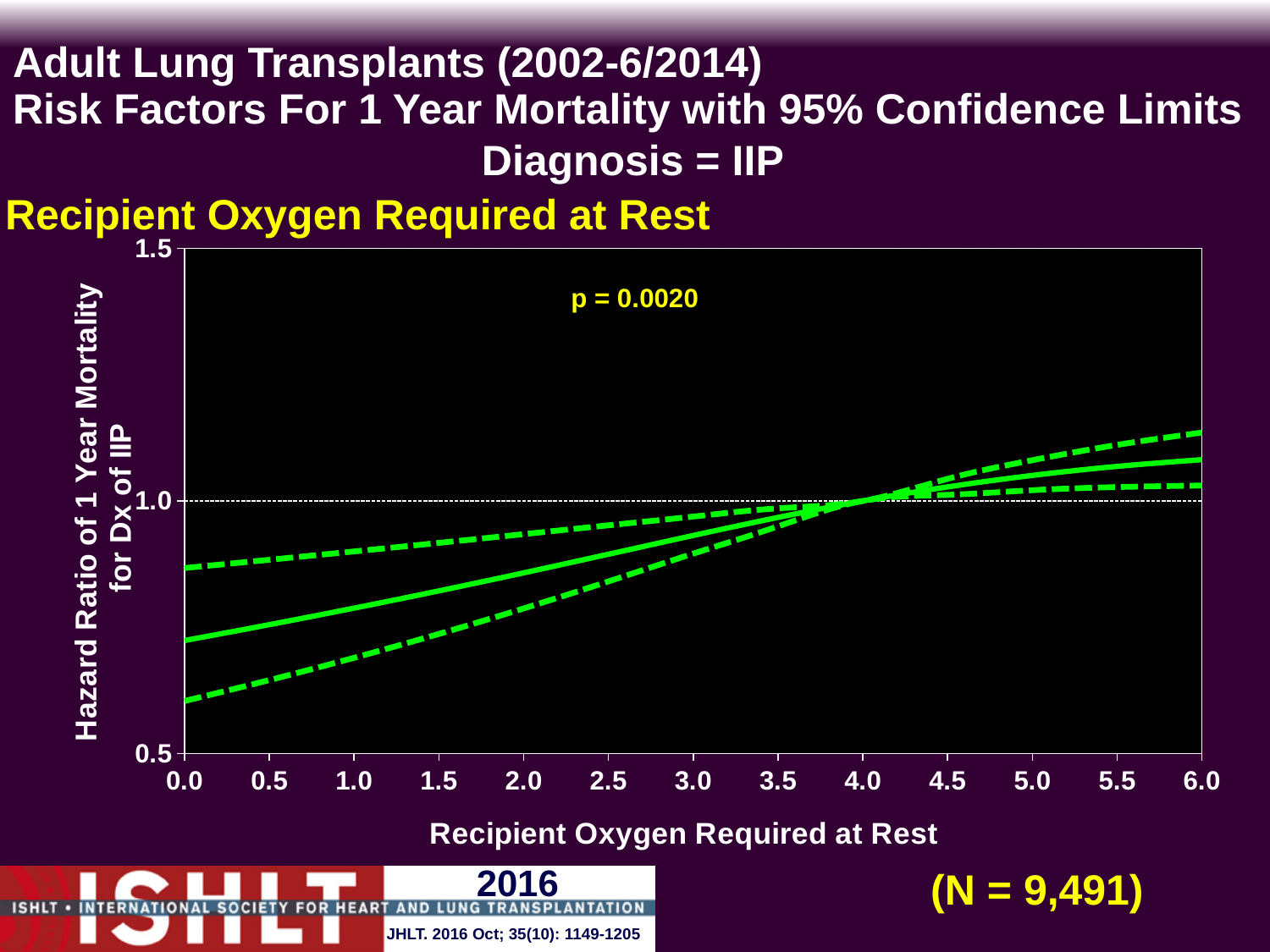
Is the lower 95% confidence limit at Recipient Oxygen Required at Rest = 0.0 greater or less than 0.5? greater What is the p-value printed on the chart? p = 0.0020 How many lines (solid and dashed) are plotted on the chart? 3 Does the hazard ratio rise or fall as Recipient Oxygen Required at Rest increases along the x axis? rises What is the label of the x axis? Recipient Oxygen Required at Rest What kind of chart is shown on the slide? line chart Is the hazard ratio (solid line) at Recipient Oxygen Required at Rest = 6.0 greater or less than 1.0? greater Is the upper 95% confidence limit at Recipient Oxygen Required at Rest = 6.0 greater or less than 1.5? less Which is larger: the hazard ratio at Recipient Oxygen Required at Rest = 1.0 or at 5.0? 5.0 What is the sample size (N) printed on the slide? N = 9,491 What is the highest value shown on the x axis? 6.0